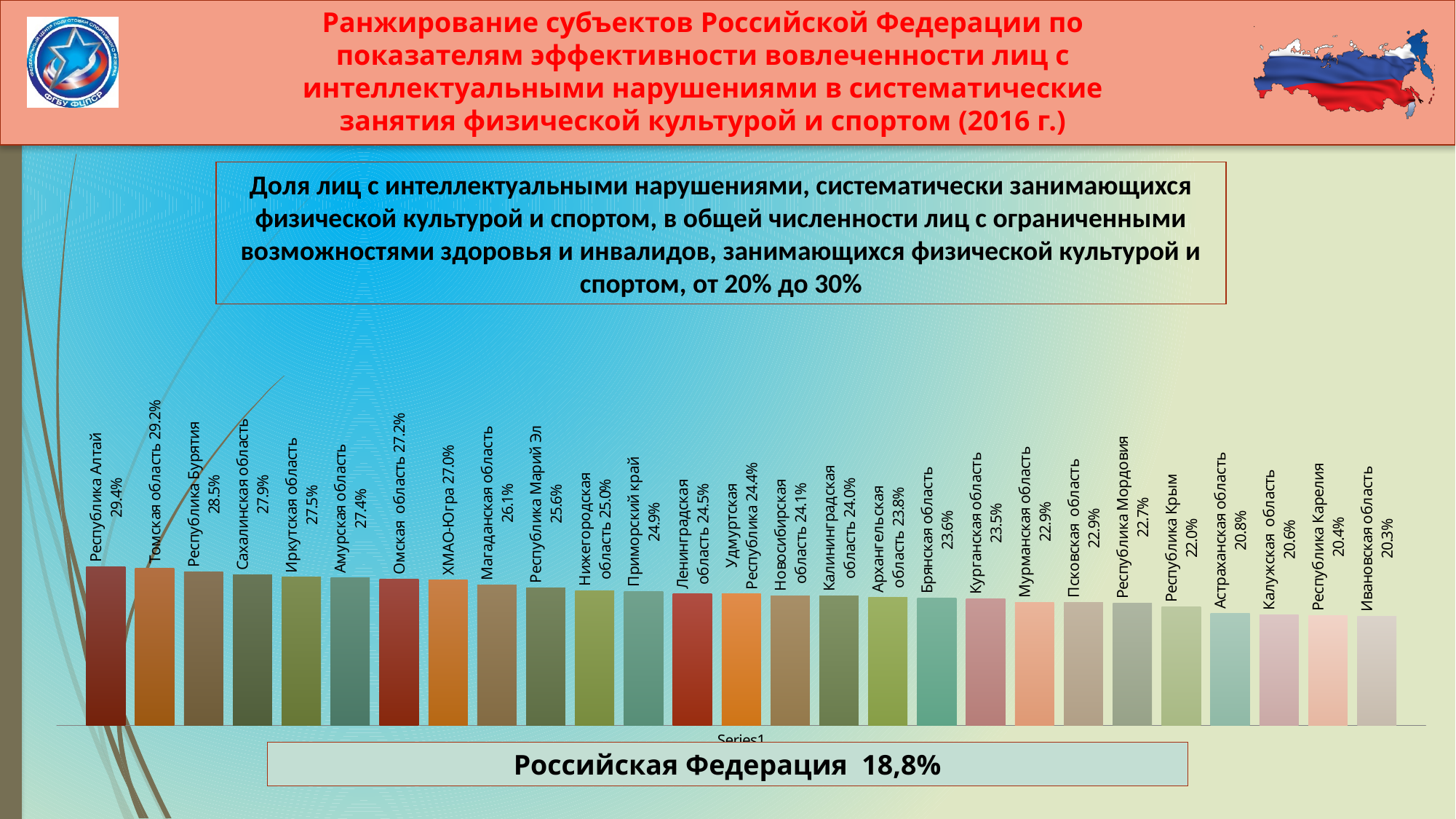
How many regions (bars) are shown in the chart? 27 What is the difference between the values for Томская область and Республика Бурятия? 0.7% What value is shown for Республика Крым? 22.0% What value is shown for Магаданская область? 26.1% Which region has the highest value in the chart? Республика Алтай What kind of chart is shown on the slide? Bar chart What is the difference between the values for Республика Алтай and Ивановская область? 9.1% What value is shown for Ивановская область? 20.3% Which is larger, the value for Омская область or the value for Приморский край? Омская область Which region has the lowest value in the chart? Ивановская область Do the values rise or fall from left to right along the x axis? Fall What value is shown for Республика Алтай? 29.4%